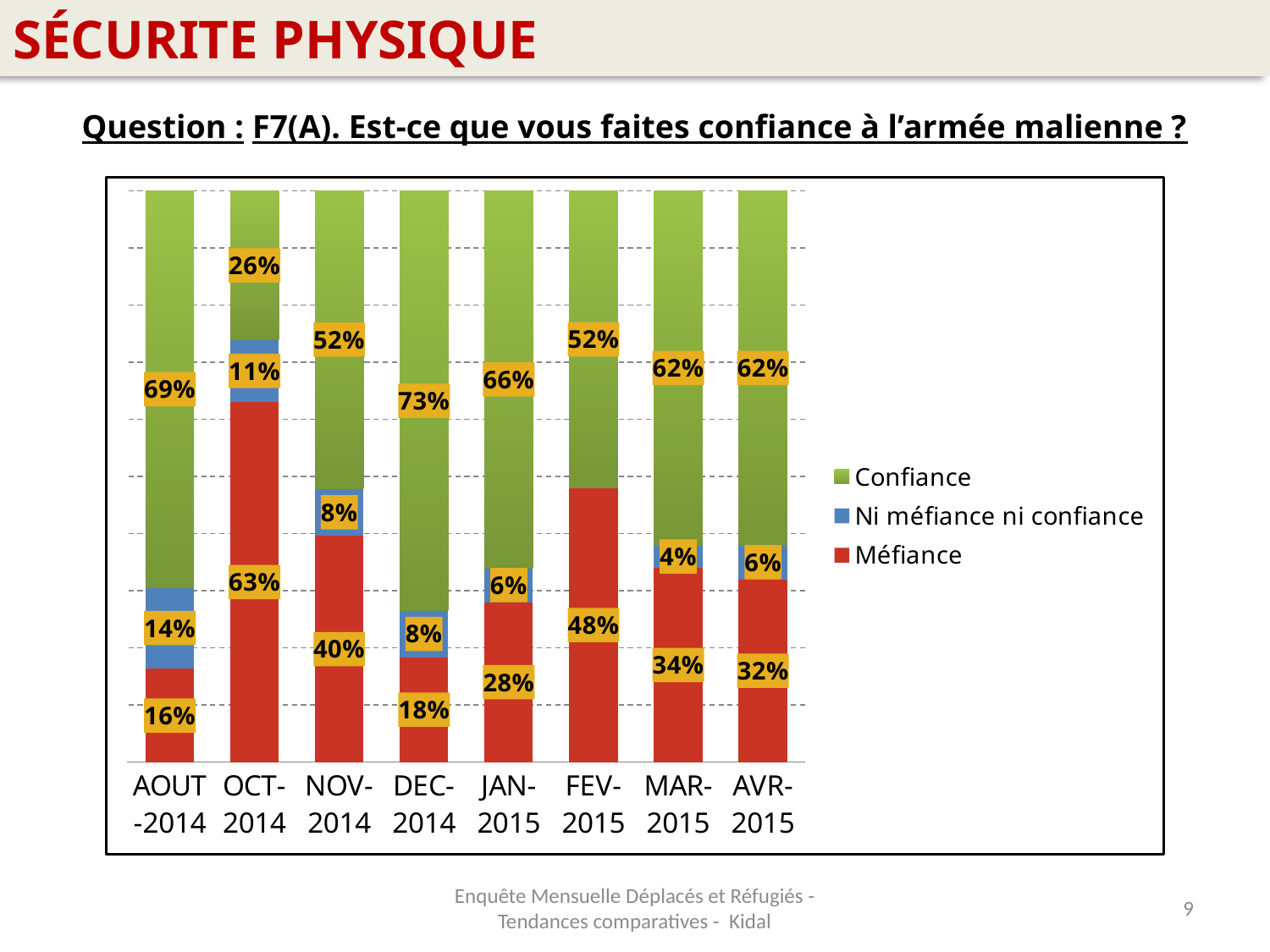
What is the Confiance value for DEC-2014? 73% Which month has the lowest Méfiance value? AOUT-2014 Which series is shown in red in the chart? Méfiance What is the Ni méfiance ni confiance value for AOUT-2014? 14% What type of chart is shown on the slide? Stacked bar chart Which month has the lowest Confiance value? OCT-2014 How many series does the legend list? 3 Which month has the highest Confiance value? DEC-2014 What is the difference between the Méfiance values for FEV-2015 and MAR-2015? 14% What is the Méfiance value for OCT-2014? 63% How many months (categories) are shown on the x axis? 8 Which is larger, the Confiance value for JAN-2015 or for NOV-2014? JAN-2015